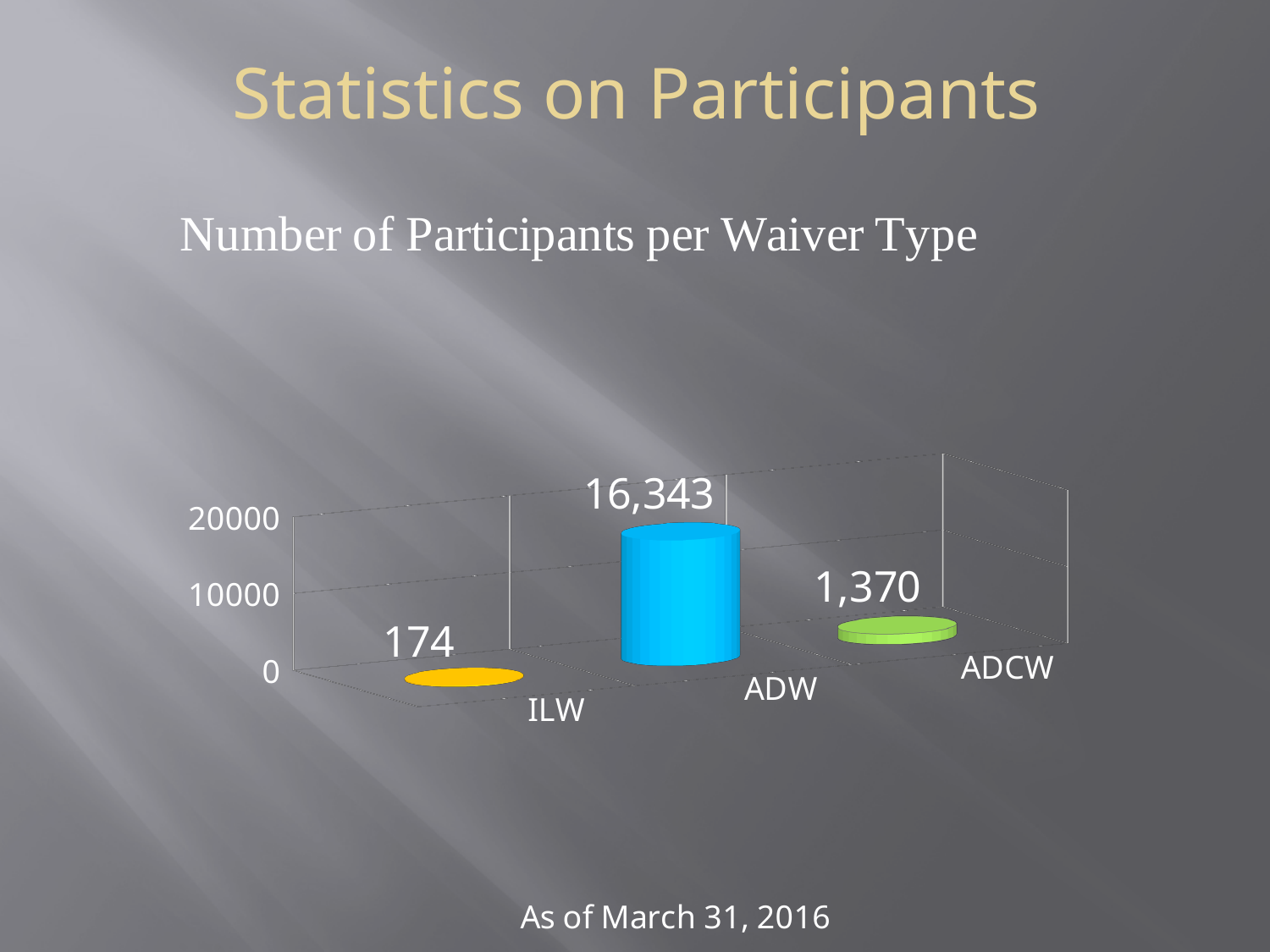
How many waiver types are shown in the chart? 3 What is the number of participants for ILW? 174 Which waiver type has the lowest number of participants? ILW What is the title of the chart? Number of Participants per Waiver Type What is the number of participants for ADCW? 1,370 What is the difference in participants between ADCW and ILW? 1,196 What is the number of participants for ADW? 16,343 What is the difference in participants between ADW and ADCW? 14,973 Which has more participants, ILW or ADCW? ADCW Which waiver type has the highest number of participants? ADW What kind of chart is shown on the slide? bar chart Is the value for ADW greater or less than 10000? greater